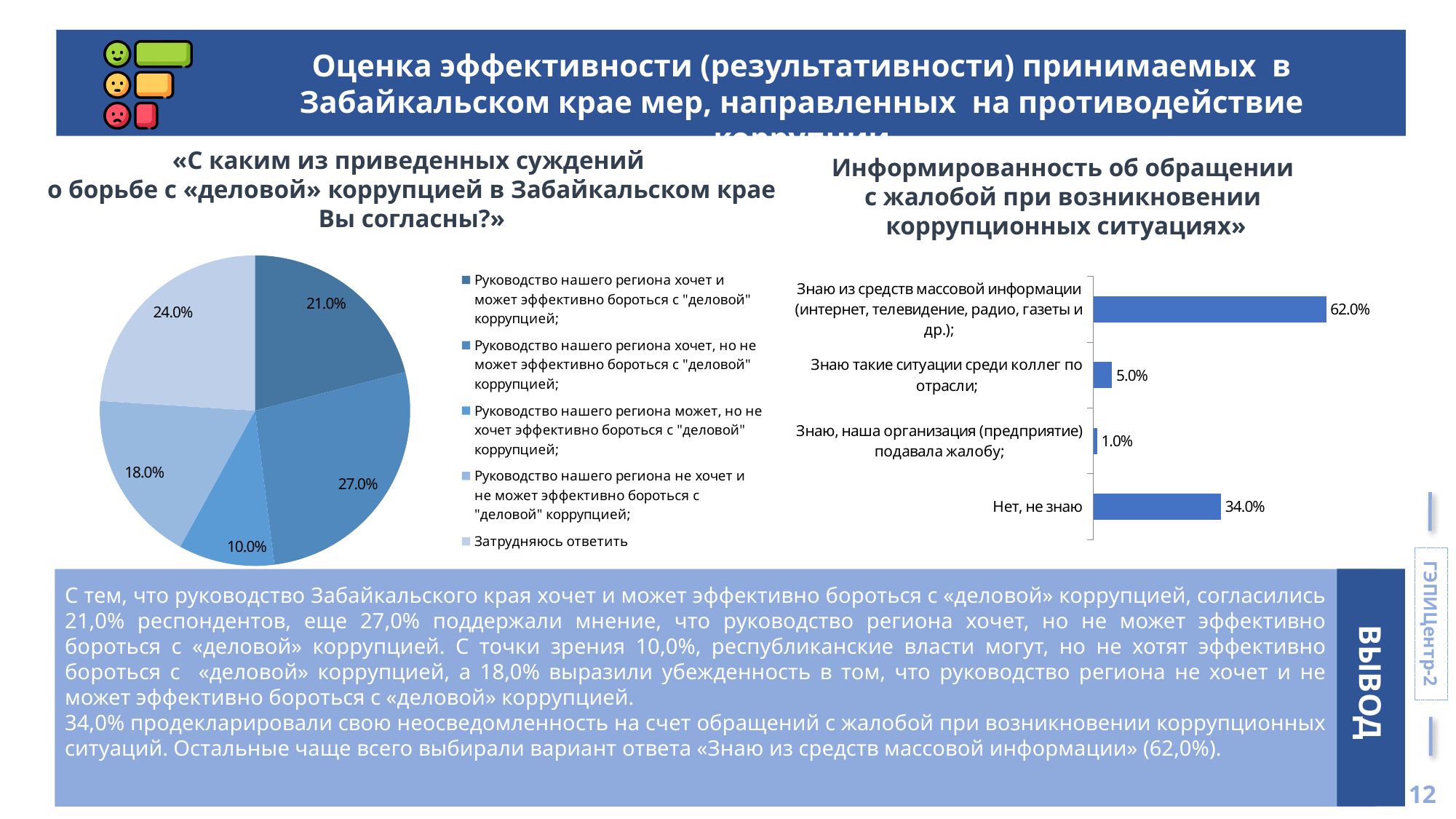
In the pie chart on the left, what percentage agreed that the regional leadership wants but cannot effectively fight "business" corruption ("хочет, но не может")? 27.0% In the bar chart on the right, what is the value for "Нет, не знаю"? 34.0% In the pie chart on the left, what share of respondents chose "Затрудняюсь ответить"? 24.0% In the bar chart on the right, what is the difference between the values for "Знаю из средств массовой информации" and "Нет, не знаю"? 28.0% In the pie chart on the left, which statement has the largest share? Руководство нашего региона хочет, но не может эффективно бороться с "деловой" коррупцией What type of chart is shown on the right side of the slide? Bar chart In the bar chart on the right, what is the value for "Знаю, наша организация (предприятие) подавала жалобу"? 1.0% In the bar chart on the right, how many categories are shown? 4 In the pie chart on the left, what is the difference between the share for "хочет, но не может" and the share for "хочет и может"? 6.0% In the pie chart on the left, which statement has the smallest share? Руководство нашего региона может, но не хочет эффективно бороться с "деловой" коррупцией In the bar chart on the right, which category has the highest value? Знаю из средств массовой информации (интернет, телевидение, радио, газеты и др.) In the pie chart on the left, how many slices are there? 5